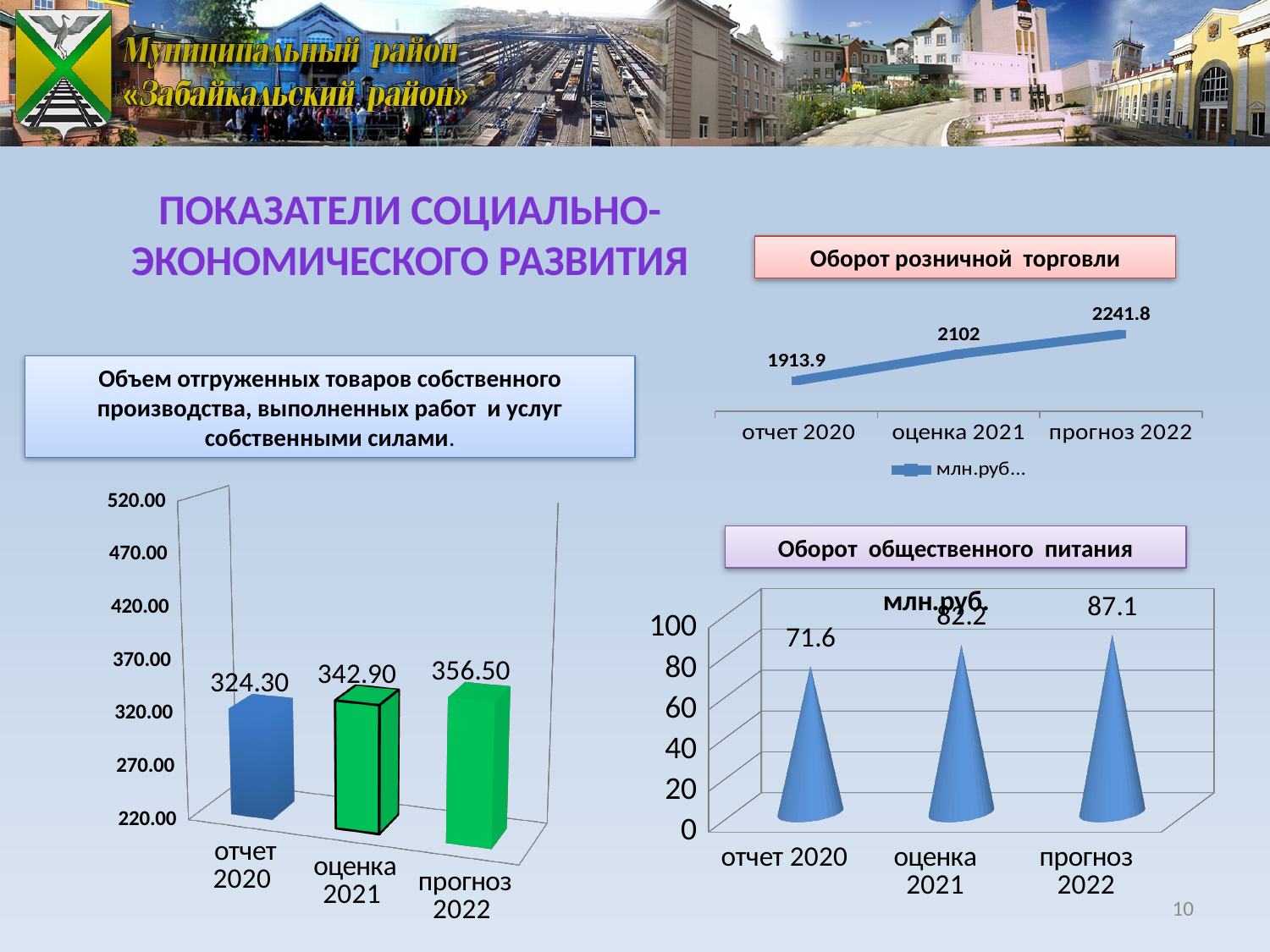
In the chart 'Оборот общественного питания', which is larger: 'отчет 2020' or 'оценка 2021'? оценка 2021 In the chart 'Оборот розничной торговли', which category has the lowest value? отчет 2020 In the chart 'Оборот общественного питания', what is the difference between 'оценка 2021' and 'отчет 2020'? 10.6 In the chart 'Оборот общественного питания', what is the value for 'прогноз 2022'? 87.1 In the chart 'Объем отгруженных товаров собственного производства, выполненных работ и услуг собственными силами', do the values rise or fall from 'отчет 2020' to 'прогноз 2022'? rise In the chart 'Оборот розничной торговли', what is the difference between 'прогноз 2022' and 'отчет 2020'? 327.9 In the chart 'Объем отгруженных товаров собственного производства, выполненных работ и услуг собственными силами', what is the difference between 'прогноз 2022' and 'оценка 2021'? 13.60 In the chart 'Объем отгруженных товаров собственного производства, выполненных работ и услуг собственными силами', what is the value for 'отчет 2020'? 324.30 In the chart 'Оборот розничной торговли', what is the value for 'оценка 2021'? 2102 What kind of chart is 'Оборот розничной торговли'? line chart In the chart 'Оборот общественного питания', how many categories are shown on the x axis? 3 In the chart 'Объем отгруженных товаров собственного производства, выполненных работ и услуг собственными силами', which category has the highest value? прогноз 2022